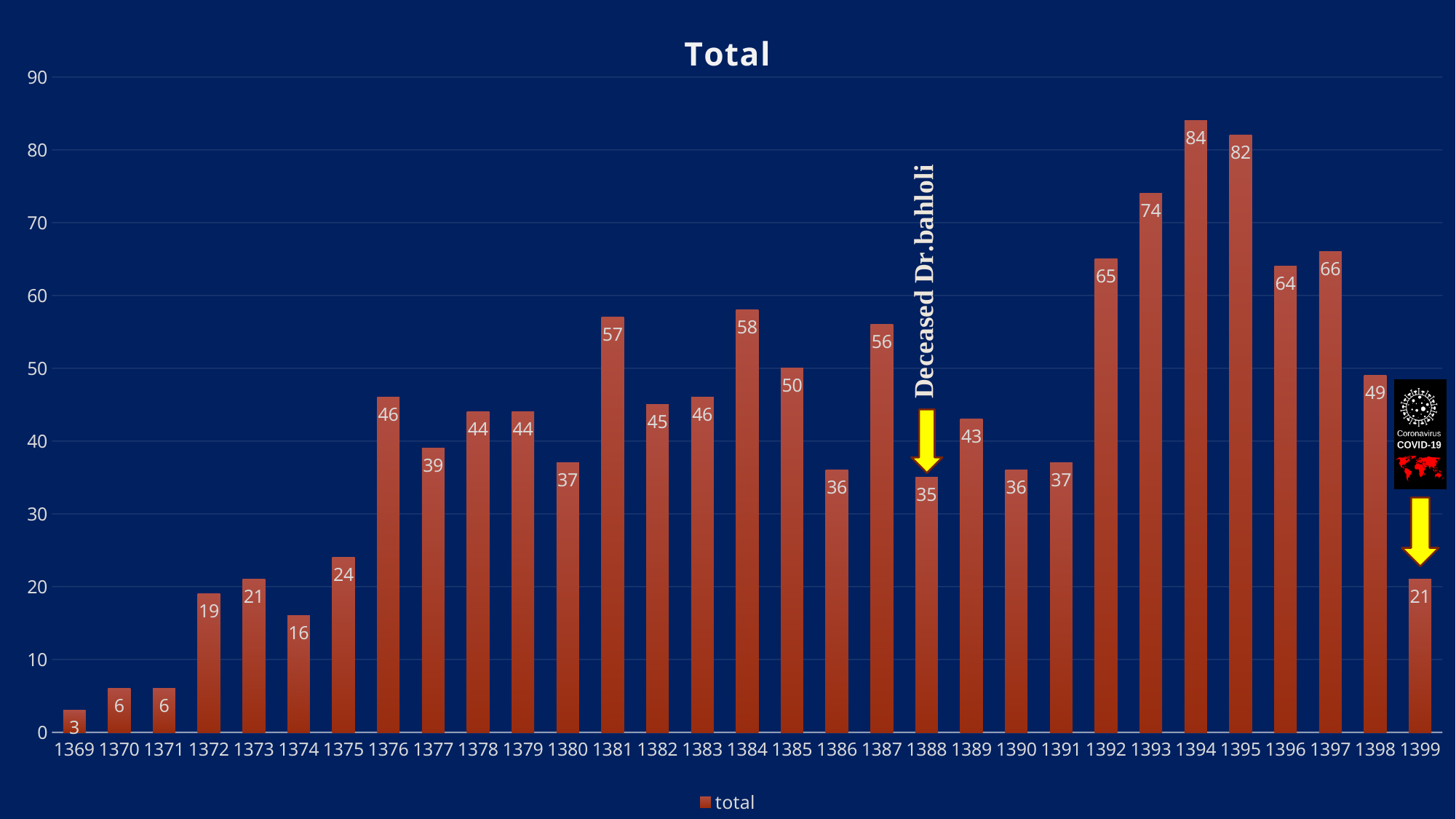
Which year has the highest value? 1394 What is the value for 1388, the year marked with the 'Deceased Dr.bahloli' annotation? 35 What is the difference between the values for 1398 and 1399? 28 What is the value for 1394? 84 What is the title of the chart? Total Is the value for 1393 greater or less than 70? greater What is the difference between the values for 1394 and 1395? 2 Which is larger, the value for 1381 or the value for 1384? 1384 How many years are shown on the x axis? 31 What is the value for 1399? 21 What kind of chart is shown on the slide? bar chart Which year has the lowest value? 1369